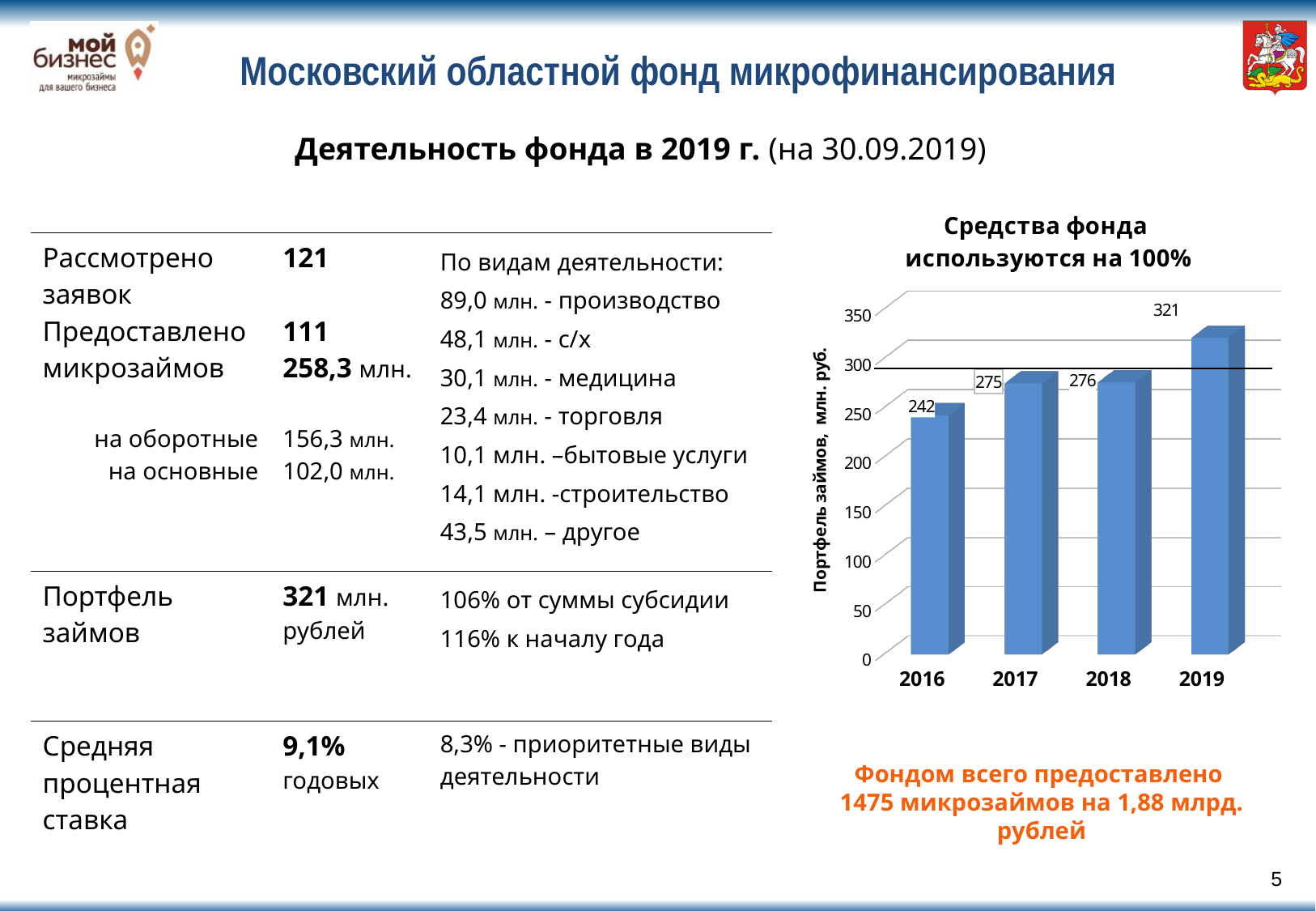
What is the difference between the values for 2019 and 2016? 79 Which year has the lowest value on the chart? 2016 What is the value for 2016 on the chart? 242 How many years are shown on the x axis of the chart? 4 What kind of chart is shown on the slide? bar chart What is the value for 2017 on the chart? 275 What is the label of the vertical axis of the chart? Портфель займов, млн. руб. Is the value for 2016 greater or less than 250? less Which year has the highest value on the chart? 2019 What is the value for 2019 on the chart? 321 Which is larger, the value for 2019 or the value for 2017? 2019 What is the value for 2018 on the chart? 276